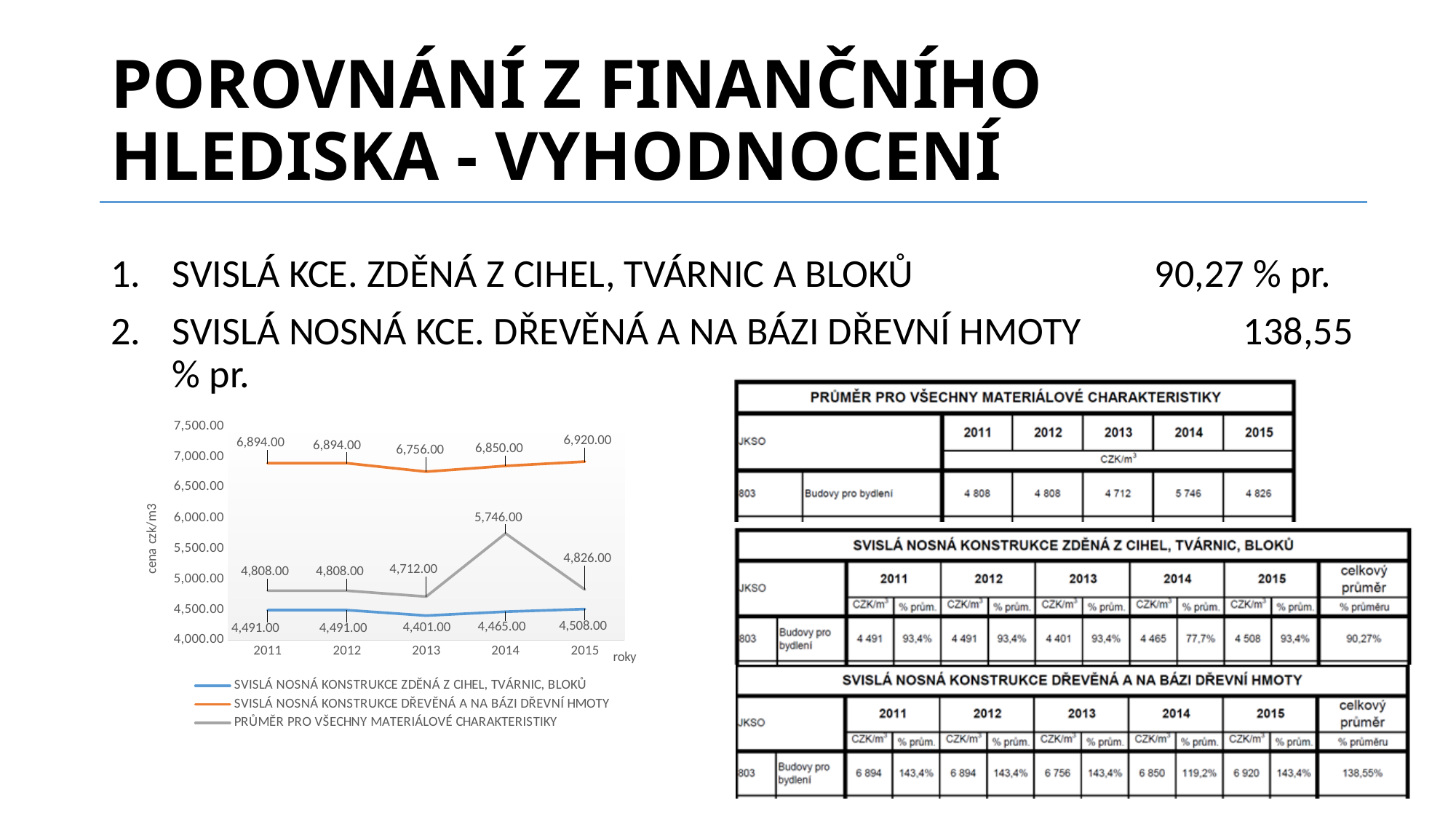
In which year does the PRŮMĚR PRO VŠECHNY MATERIÁLOVÉ CHARAKTERISTIKY series reach its highest value? 2014 What is the difference between the SVISLÁ NOSNÁ KONSTRUKCE DŘEVĚNÁ A NA BÁZI DŘEVNÍ HMOTY value and the SVISLÁ NOSNÁ KONSTRUKCE ZDĚNÁ Z CIHEL, TVÁRNIC, BLOKŮ value in 2015? 2,412.00 How many years are plotted on the x axis of the chart? 5 In which year does the SVISLÁ NOSNÁ KONSTRUKCE ZDĚNÁ Z CIHEL, TVÁRNIC, BLOKŮ series have its lowest value? 2013 What is the value for SVISLÁ NOSNÁ KONSTRUKCE DŘEVĚNÁ A NA BÁZI DŘEVNÍ HMOTY in 2013? 6,756.00 Which series has the higher value in 2011: SVISLÁ NOSNÁ KONSTRUKCE DŘEVĚNÁ A NA BÁZI DŘEVNÍ HMOTY or PRŮMĚR PRO VŠECHNY MATERIÁLOVÉ CHARAKTERISTIKY? SVISLÁ NOSNÁ KONSTRUKCE DŘEVĚNÁ A NA BÁZI DŘEVNÍ HMOTY What is the value for PRŮMĚR PRO VŠECHNY MATERIÁLOVÉ CHARAKTERISTIKY in 2014? 5,746.00 Does the SVISLÁ NOSNÁ KONSTRUKCE DŘEVĚNÁ A NA BÁZI DŘEVNÍ HMOTY series rise or fall from 2013 to 2015? rise What is the value for SVISLÁ NOSNÁ KONSTRUKCE ZDĚNÁ Z CIHEL, TVÁRNIC, BLOKŮ in 2015? 4,508.00 What type of chart is shown on the slide? line chart What is the label of the y axis of the chart? cena czk/m3 How many series does the chart legend list? 3